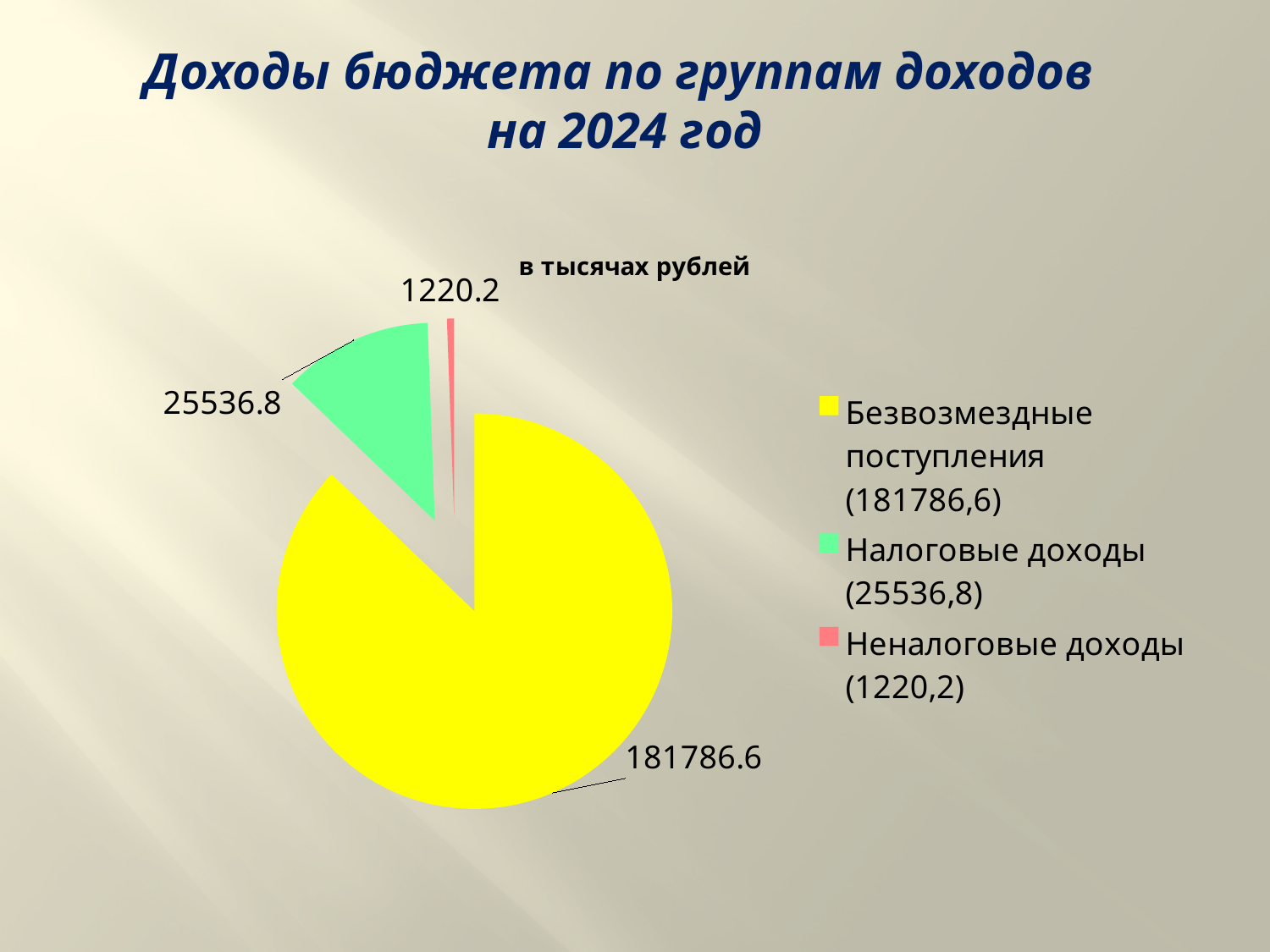
How many entries does the legend list? 3 What is the difference between the values for Налоговые доходы and Неналоговые доходы? 24316.6 What is the value shown for Безвозмездные поступления? 181786.6 What is the value shown for Налоговые доходы? 25536.8 What is the difference between the values for Безвозмездные поступления and Налоговые доходы? 156249.8 Which category has the largest slice of the pie? Безвозмездные поступления What kind of chart is shown on the slide? Pie chart Which is larger, the value for Налоговые доходы or the value for Неналоговые доходы? Налоговые доходы What is the value shown for Неналоговые доходы? 1220.2 Which category has the smallest slice of the pie? Неналоговые доходы What unit is stated in the chart's title above the pie? в тысячах рублей How many slices does the pie chart have? 3